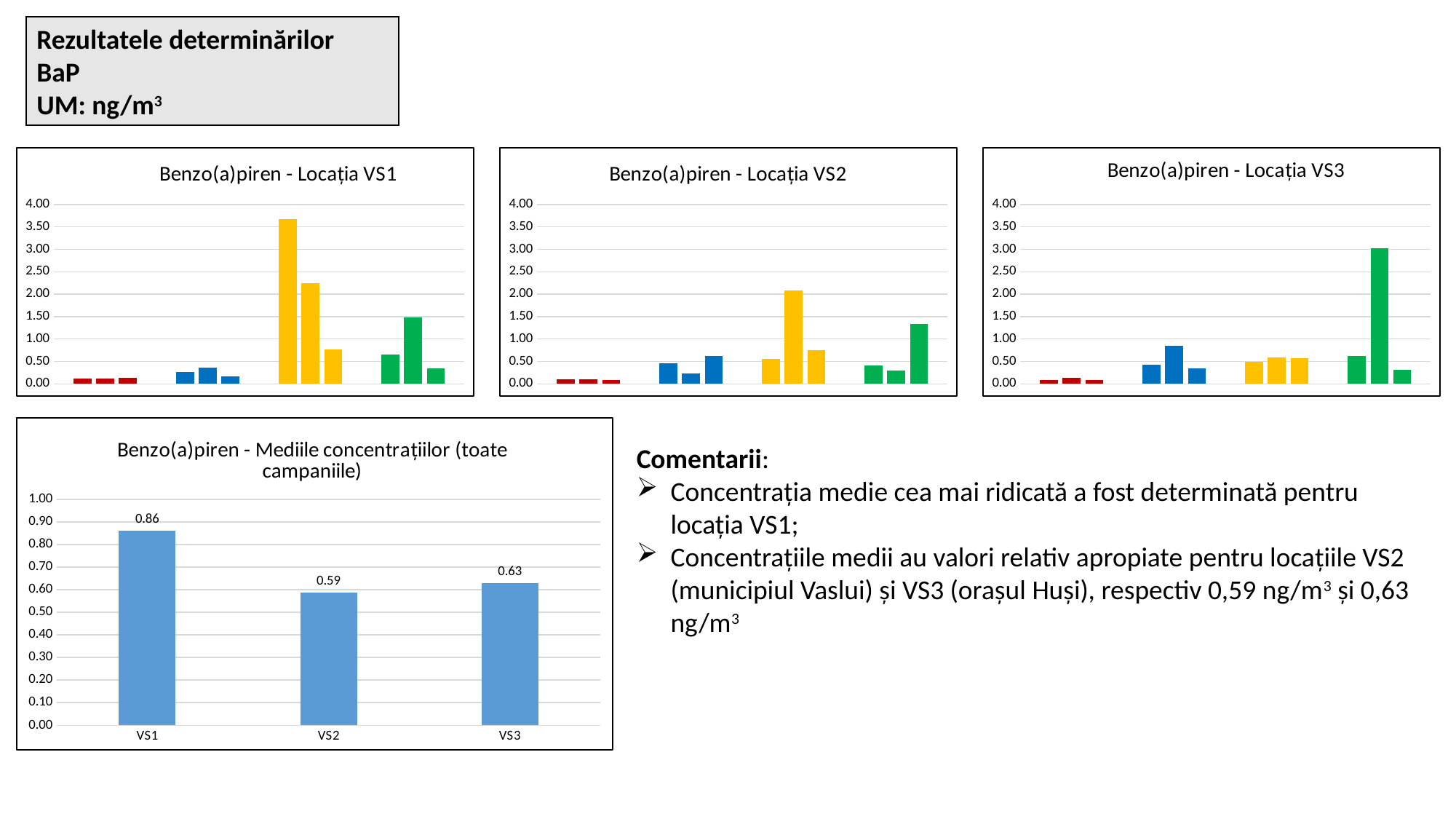
How many locations are shown in the chart 'Benzo(a)piren - Mediile concentrațiilor (toate campaniile)'? 3 In the chart 'Benzo(a)piren - Mediile concentrațiilor (toate campaniile)', which location has the lowest value? VS2 In the chart 'Benzo(a)piren - Mediile concentrațiilor (toate campaniile)', what is the difference between the values for VS1 and VS3? 0.23 In the chart 'Benzo(a)piren - Mediile concentrațiilor (toate campaniile)', which location has the highest value? VS1 In the chart 'Benzo(a)piren - Mediile concentrațiilor (toate campaniile)', what is the value for VS3? 0.63 In the chart 'Benzo(a)piren - Mediile concentrațiilor (toate campaniile)', what is the value for VS2? 0.59 In the chart 'Benzo(a)piren - Locația VS1', is the tallest bar greater or less than 3.50? greater What kind of chart is 'Benzo(a)piren - Mediile concentrațiilor (toate campaniile)'? Bar chart How many bars are plotted in the chart 'Benzo(a)piren - Locația VS3'? 12 In the chart 'Benzo(a)piren - Mediile concentrațiilor (toate campaniile)', which is larger, the value for VS2 or VS3? VS3 In the chart 'Benzo(a)piren - Locația VS2', is the tallest bar greater or less than 1.50? greater In the chart 'Benzo(a)piren - Mediile concentrațiilor (toate campaniile)', what is the value for VS1? 0.86